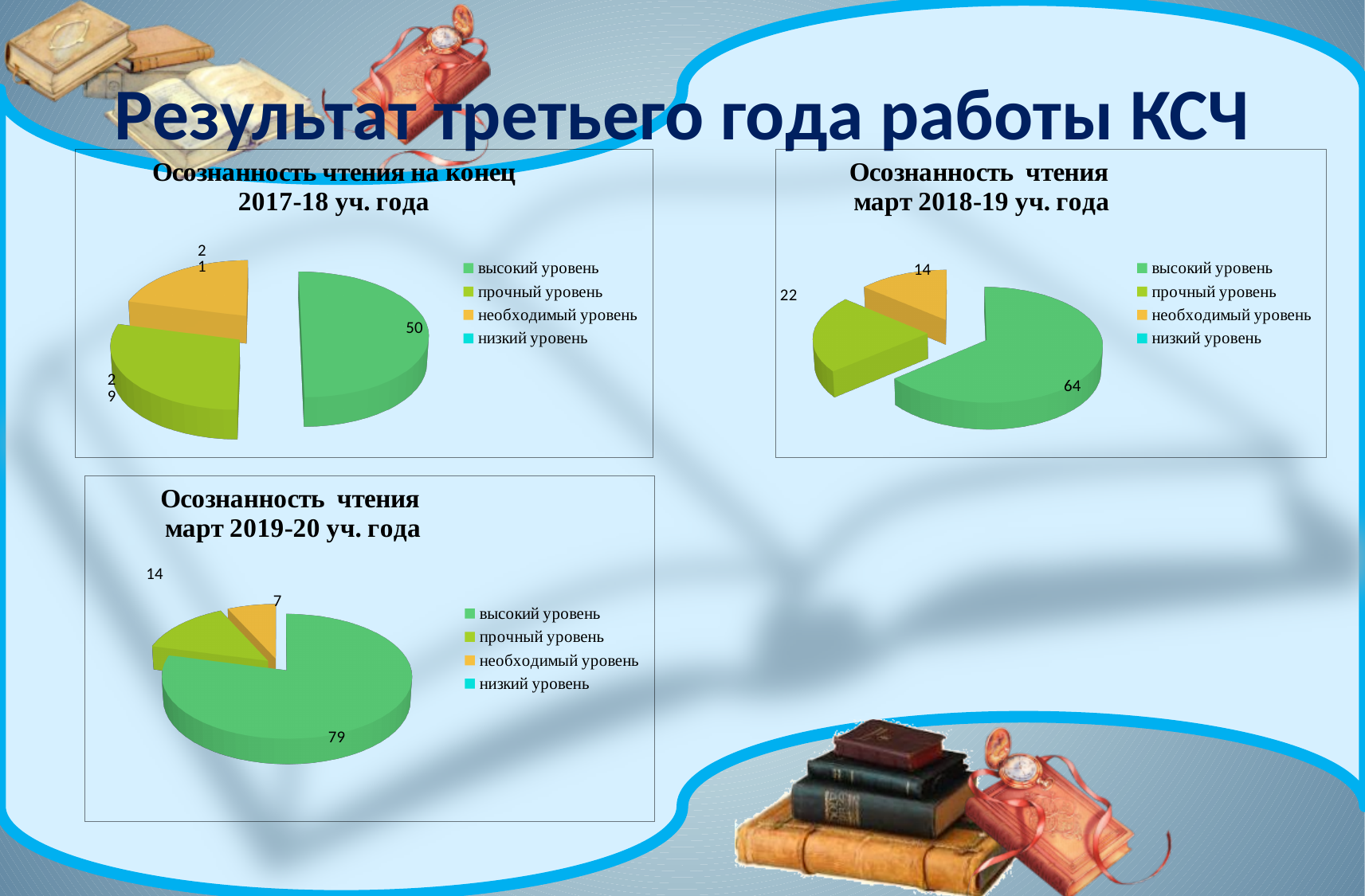
How many slices are visible in the pie of the chart titled "Осознанность чтения март 2018-19 уч. года"? 3 In the chart titled "Осознанность чтения на конец 2017-18 уч. года", what value is shown for высокий уровень? 50 How many entries does the legend list in the chart titled "Осознанность чтения март 2019-20 уч. года"? 4 What type of chart is the chart titled "Осознанность чтения на конец 2017-18 уч. года"? pie chart In the chart titled "Осознанность чтения март 2018-19 уч. года", what value is shown for прочный уровень? 22 In the chart titled "Осознанность чтения март 2019-20 уч. года", which category has the largest slice? высокий уровень In the chart titled "Осознанность чтения март 2019-20 уч. года", what value is shown for необходимый уровень? 7 In the chart titled "Осознанность чтения март 2019-20 уч. года", what share of the pie does высокий уровень represent? 79% In the chart titled "Осознанность чтения март 2018-19 уч. года", which labelled category has the smallest slice? необходимый уровень In the chart titled "Осознанность чтения март 2018-19 уч. года", what is the difference between the values for высокий уровень and необходимый уровень? 50 In the chart titled "Осознанность чтения на конец 2017-18 уч. года", which is larger: the value for прочный уровень or the value for необходимый уровень? прочный уровень In the chart titled "Осознанность чтения март 2019-20 уч. года", what is the difference between the values for высокий уровень and прочный уровень? 65